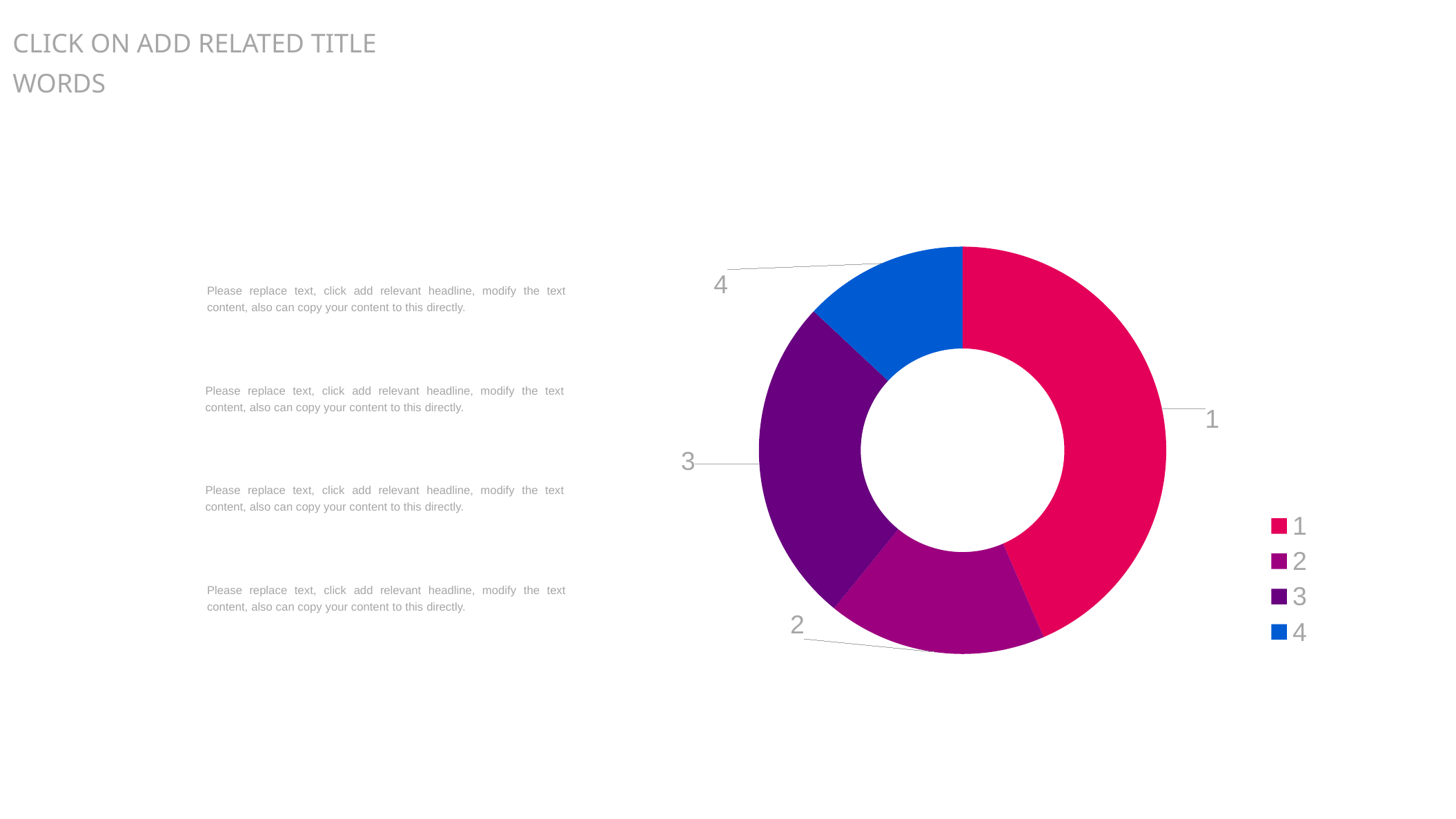
Which category has the largest slice in the doughnut chart? 1 What kind of chart is shown on the slide? Doughnut chart Which slice is larger in the doughnut chart, category 2 or category 3? 3 What are the labels listed in the legend of the doughnut chart? 1, 2, 3, 4 How many slices does the doughnut chart have? 4 Which slice is larger in the doughnut chart, category 2 or category 4? 2 What colour is the slice for category 4 in the doughnut chart? Blue Which slice is larger in the doughnut chart, category 1 or category 2? 1 Which category has the smallest slice in the doughnut chart? 4 How many entries does the legend of the doughnut chart list? 4